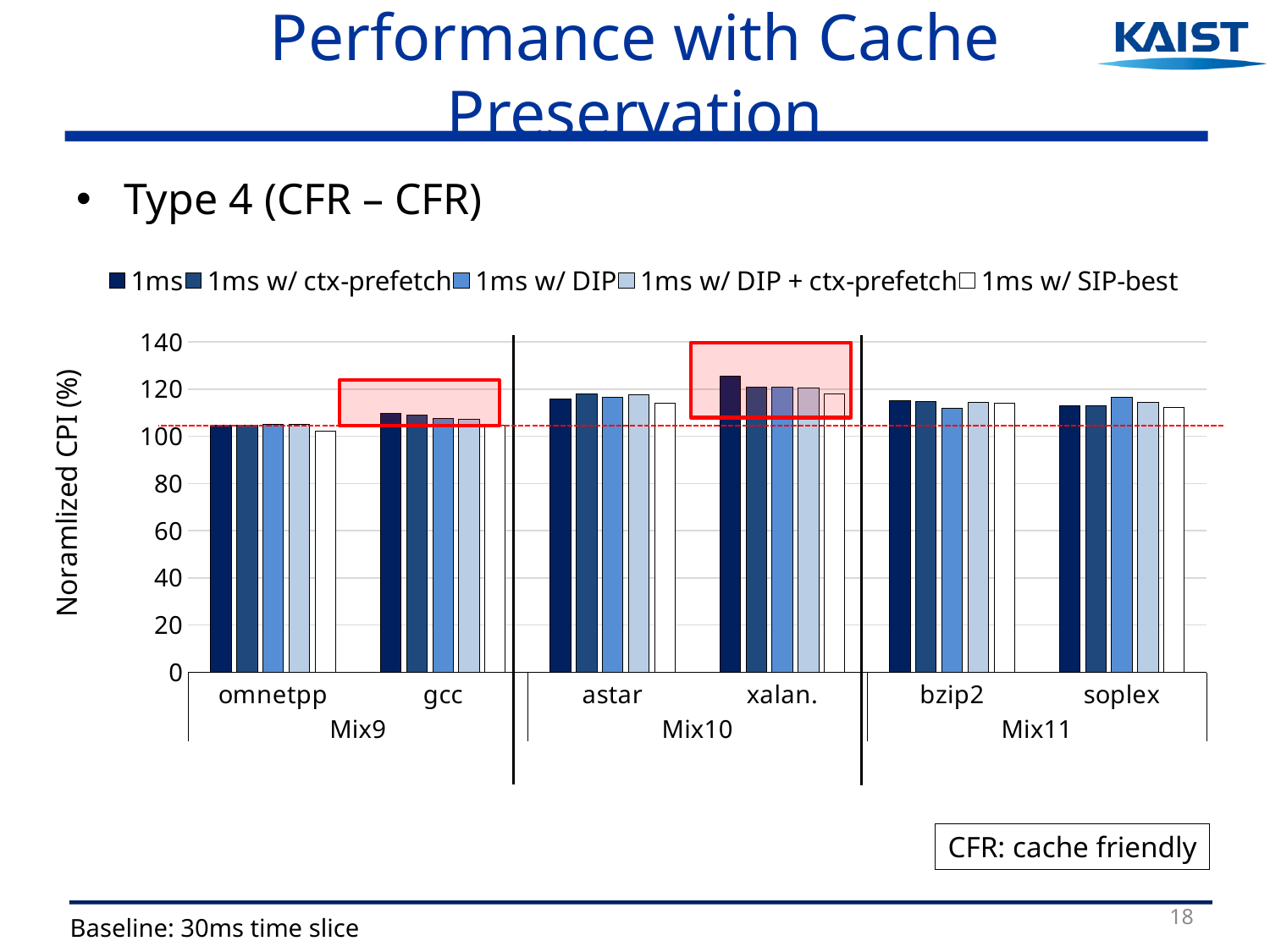
Is the value for gcc in the 1ms w/ SIP-best series greater or less than 120? less How many benchmark categories are plotted along the x axis? 6 Which mix group contains the benchmarks bzip2 and soplex? Mix11 Is the value for astar in the 1ms series greater or less than 100? greater Is the value for xalan. in the 1ms series greater or less than 120? greater Which benchmark has the highest 1ms bar? xalan. What kind of chart is shown on the slide? bar chart What is the label of the y axis? Noramlized CPI (%) Which benchmark has the lowest 1ms w/ SIP-best bar? omnetpp Which is larger, the 1ms value for xalan. or the 1ms value for omnetpp? xalan. How many series does the legend list? 5